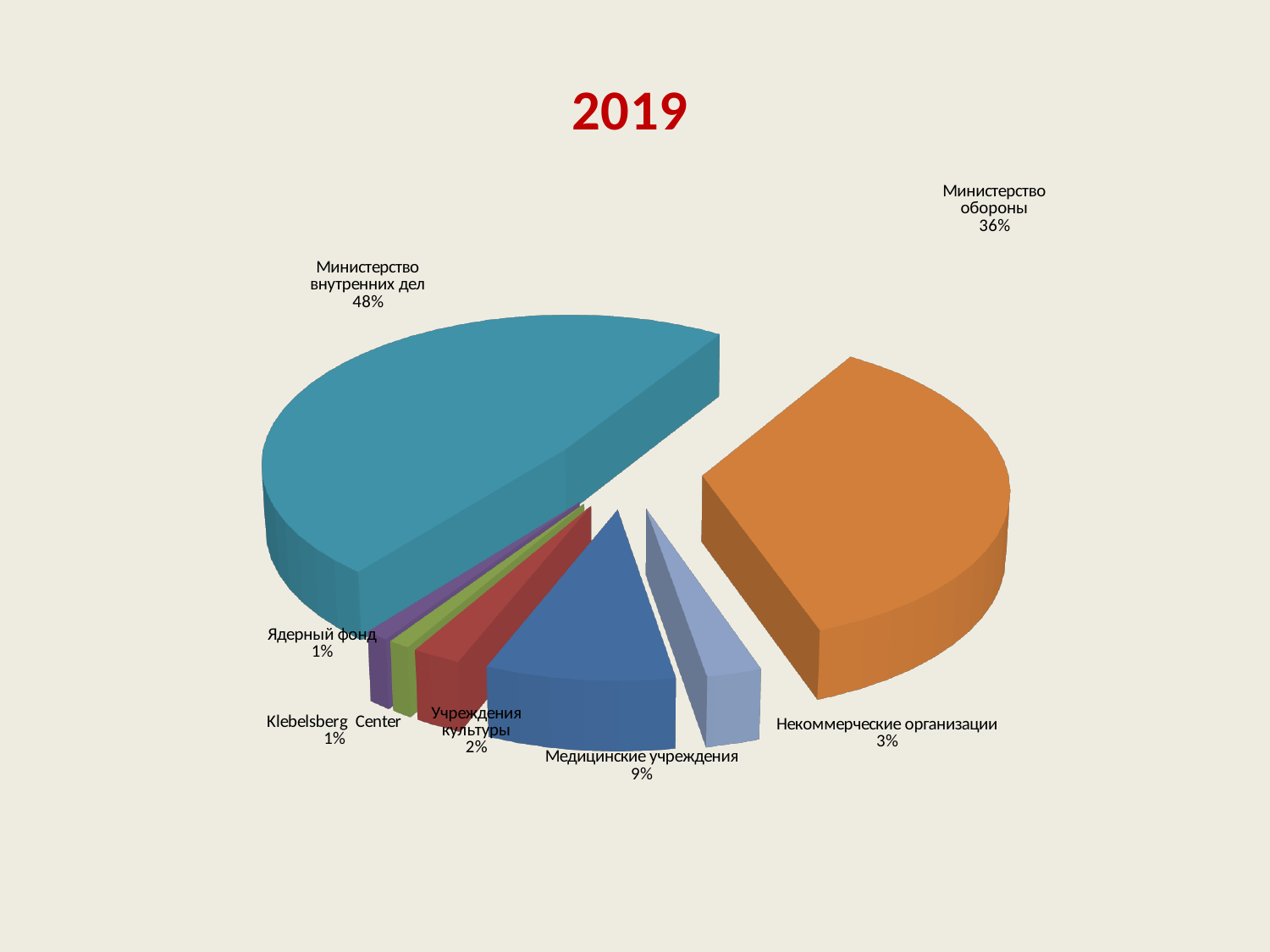
What is the difference in percentage points between Министерство внутренних дел and Министерство обороны? 12 What share of the pie does Учреждения культуры have? 2% What share of the pie does Klebelsberg Center have? 1% What share of the pie does Министерство внутренних дел have? 48% How many slices does the pie chart have? 7 Which category has the largest slice of the pie? Министерство внутренних дел What kind of chart is shown on the slide? pie chart Which is larger, the share for Медицинские учреждения or the share for Некоммерческие организации? Медицинские учреждения What is the title of the chart? 2019